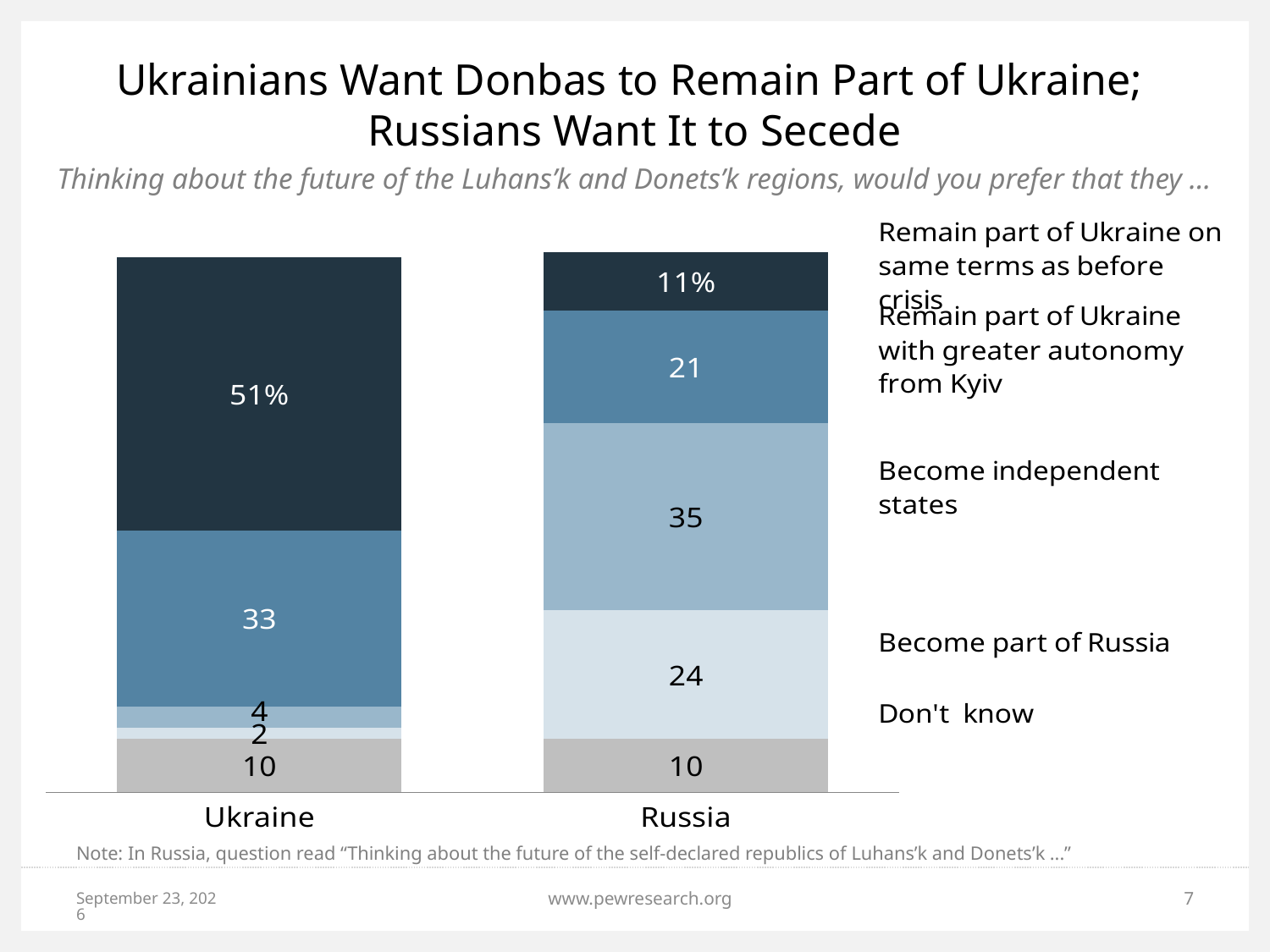
How many response categories are stacked in each bar? 5 What is the 'Don't know' value for Russia? 10 What value is shown for Russia for 'Become independent states'? 35 What is the difference between the Ukraine and Russia values for 'Remain part of Ukraine on same terms as before crisis'? 40 Which response has the largest share in the Russia bar? Become independent states Which response has the smallest share in the Ukraine bar? Become part of Russia What value is shown for Russia for 'Become part of Russia'? 24 How many countries are shown as bars in the chart? 2 What type of chart is shown on the slide? Stacked bar chart What value is shown for Ukraine for 'Remain part of Ukraine with greater autonomy from Kyiv'? 33 Which country has the larger value for 'Become part of Russia'? Russia What percentage of Ukrainians want Donbas to remain part of Ukraine on the same terms as before the crisis? 51%